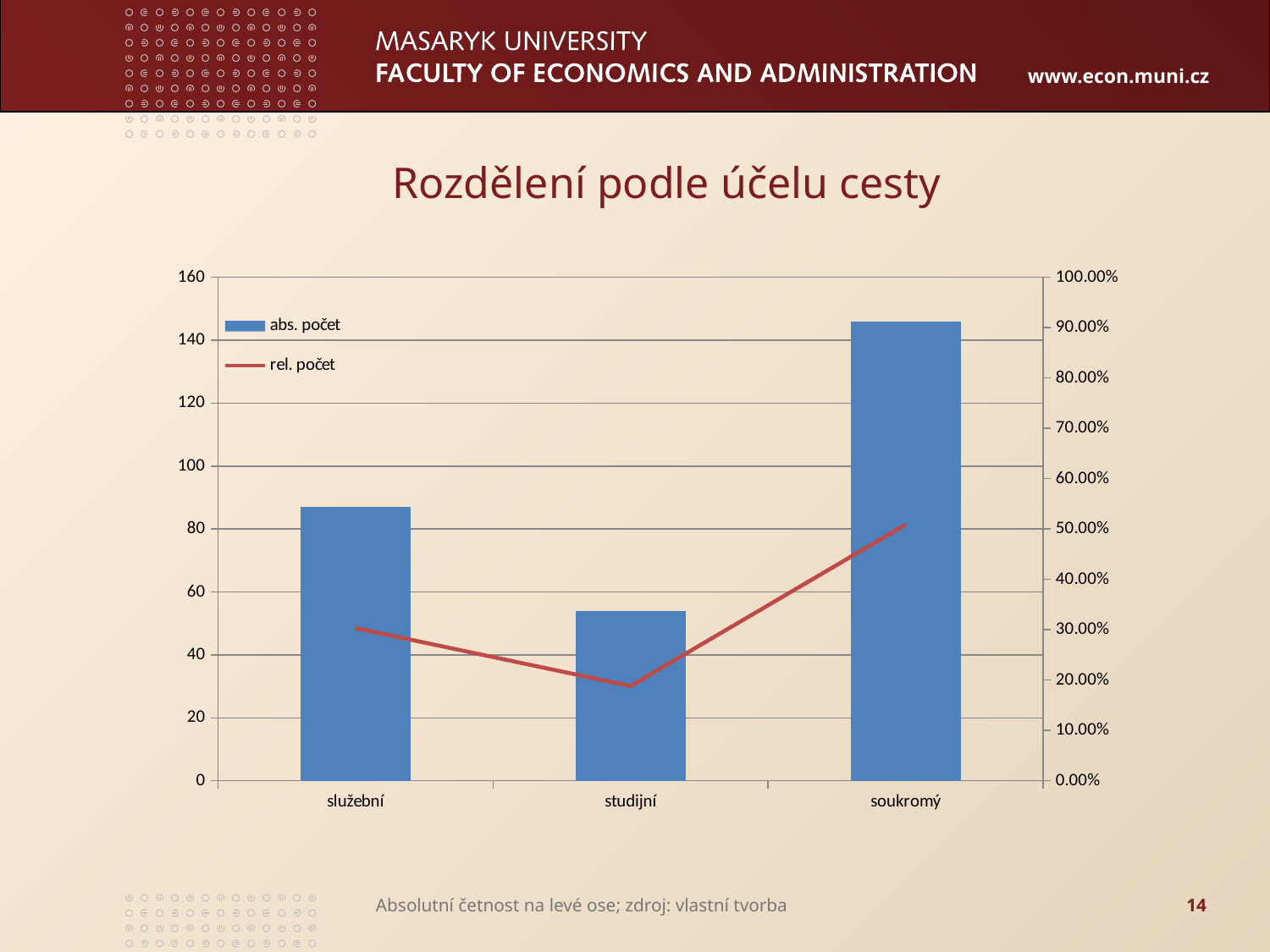
What kind of chart is shown on the slide? bar chart with a line Which category has the highest abs. počet bar? soukromý How many categories are shown on the x axis? 3 Which series is drawn as a red line? rel. počet Which category has the lowest abs. počet bar? studijní Is the abs. počet value for soukromý greater or less than 140? greater How many series does the legend list? 2 Which has a larger abs. počet bar, služební or studijní? služební Is the abs. počet value for služební greater or less than 100? less Is the abs. počet value for studijní greater or less than 60? less What is the title of the chart? Rozdělení podle účelu cesty